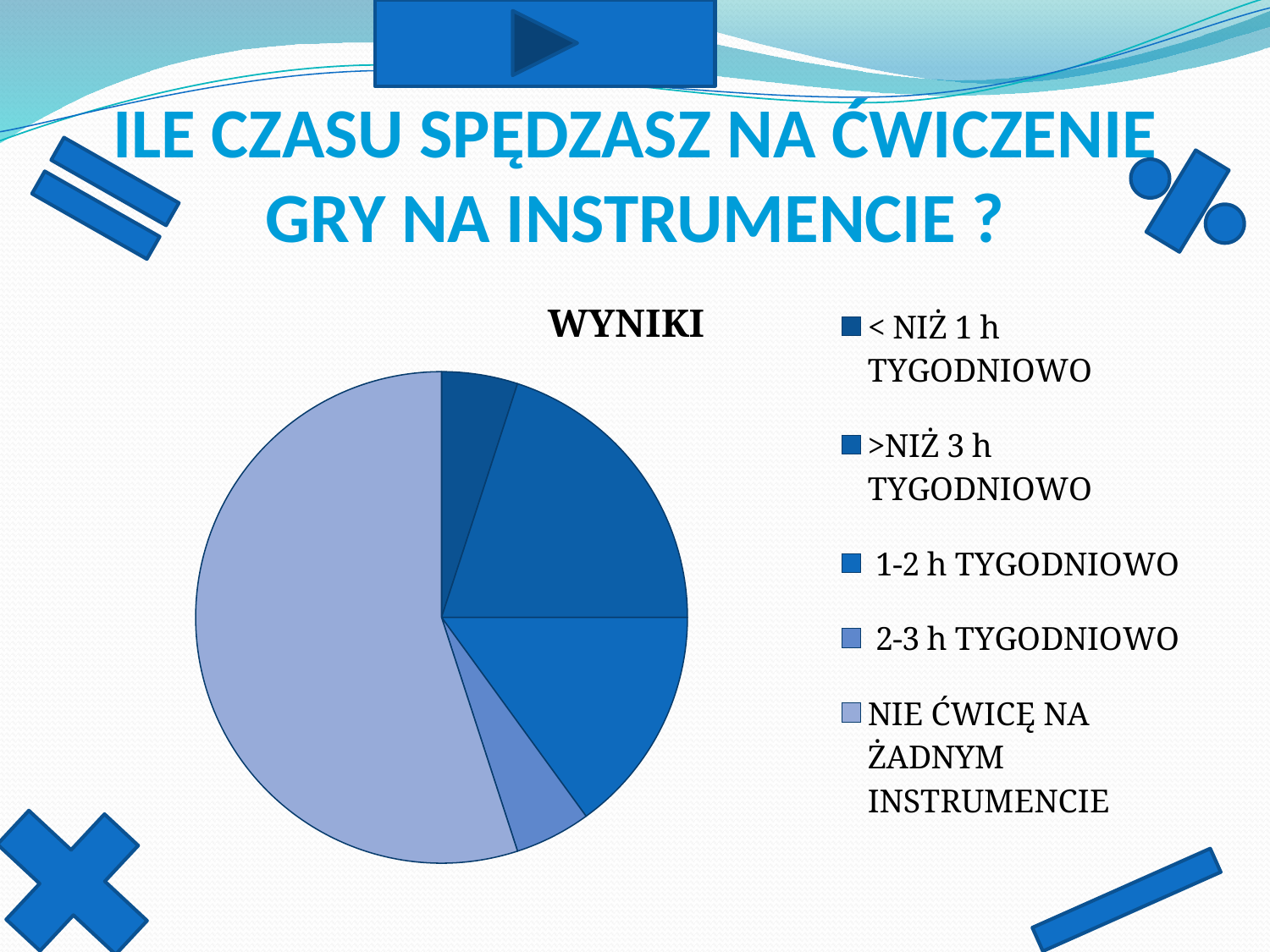
Which category has the largest slice of the pie? NIE ĆWICĘ NA ŻADNYM INSTRUMENCIE What kind of chart is shown on the slide? pie chart What is the title of the chart? WYNIKI Which slice is larger: NIE ĆWICZĘ NA ŻADNYM INSTRUMENCIE or 1-2 h TYGODNIOWO? NIE ĆWICĘ NA ŻADNYM INSTRUMENCIE Which slice is larger: 1-2 h TYGODNIOWO or 2-3 h TYGODNIOWO? 1-2 h TYGODNIOWO Which slice is larger: >NIŻ 3 h TYGODNIOWO or 2-3 h TYGODNIOWO? >NIŻ 3 h TYGODNIOWO Which legend entry is listed first? < NIŻ 1 h TYGODNIOWO How many categories does the pie chart have? 5 Is the slice for NIE ĆWICZĘ NA ŻADNYM INSTRUMENCIE more or less than half of the pie? more How many entries does the legend list? 5